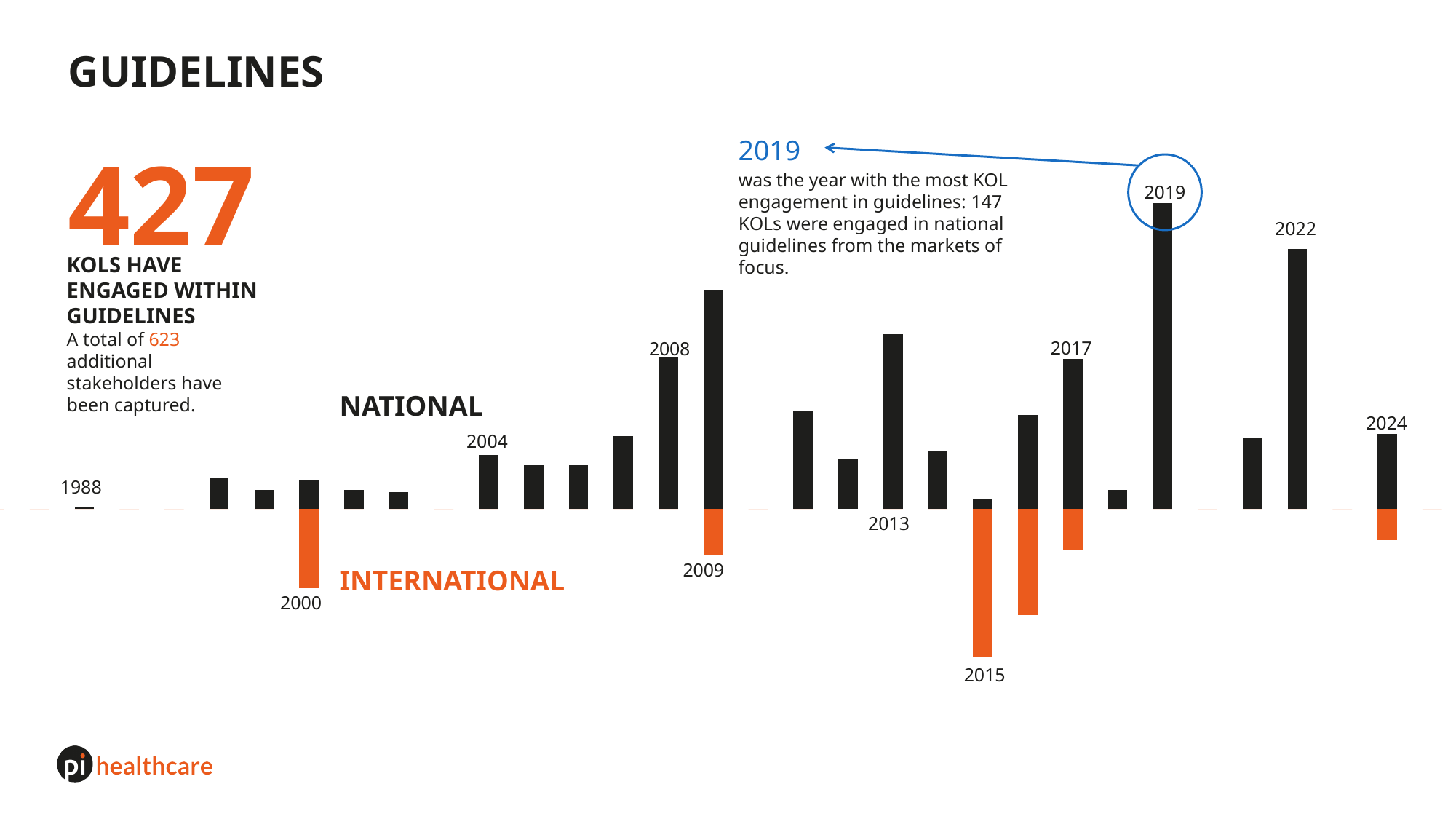
How many series does the chart show? 2 Which labelled year has the smallest NATIONAL bar? 1988 Which is larger, the NATIONAL bar for 2004 or for 2008? 2008 How many KOLs were engaged in national guidelines in 2019? 147 What colour are the INTERNATIONAL bars? orange What kind of chart is shown on the slide? bar chart Which year has the highest NATIONAL bar? 2019 Which year has the largest INTERNATIONAL bar? 2015 Which is larger, the NATIONAL bar for 2019 or for 2022? 2019 Which series is plotted below the horizontal axis? INTERNATIONAL Which is larger, the NATIONAL bar for 2008 or for 2009? 2009